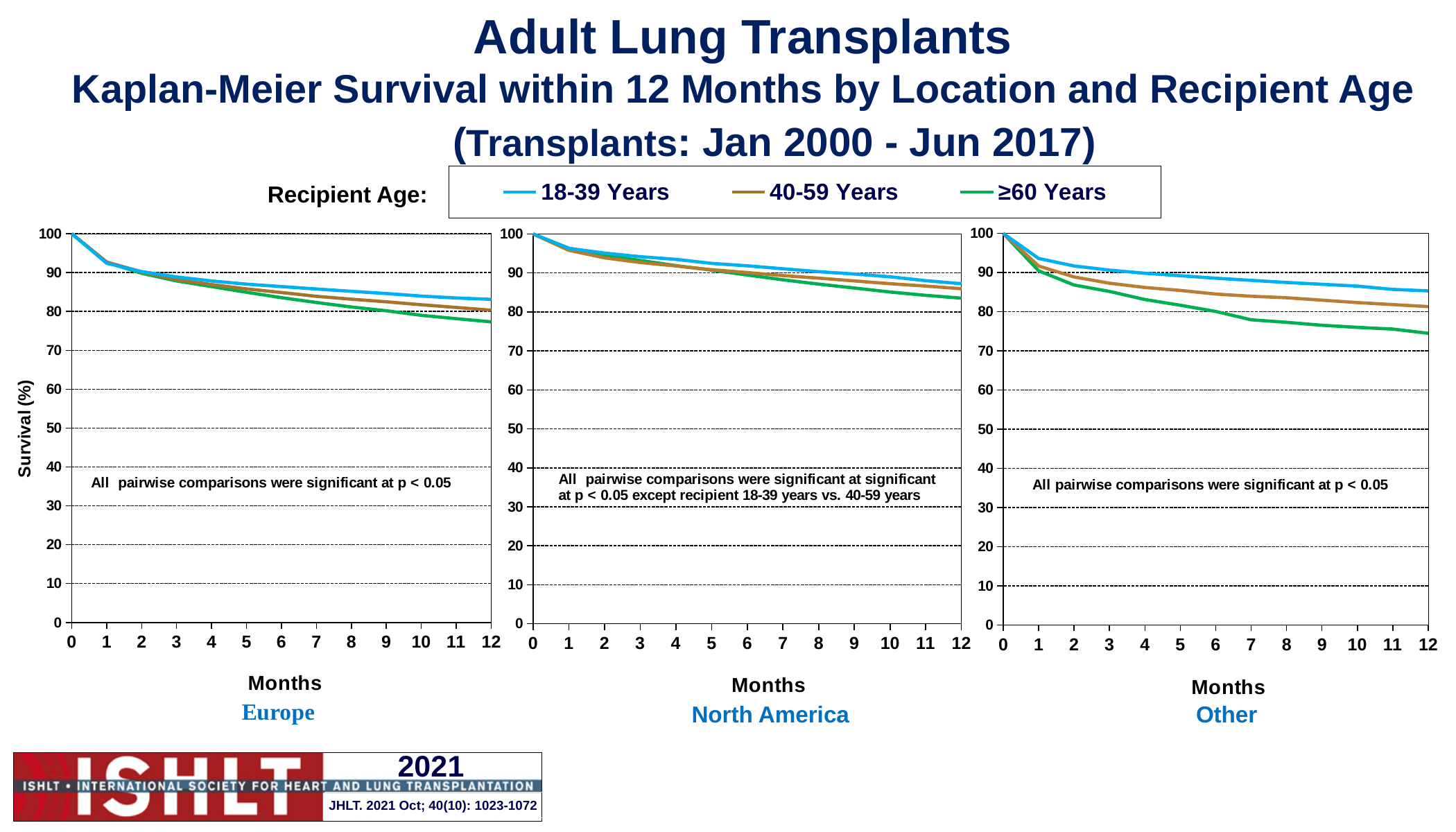
In the North America chart, do the survival values rise or fall as months increase? fall In the Other chart, which series has the lowest survival at month 12? ≥60 Years In the Europe chart, is the value for 18-39 Years at month 12 greater or less than 80? greater What kind of chart is the Europe chart? line chart How many charts are shown on the slide? 3 How many series does the legend list? 3 In the Europe chart, is the value for ≥60 Years at month 12 greater or less than 80? less In the North America chart, is the value for ≥60 Years at month 12 greater or less than 80? greater What colour is the line for the ≥60 Years series in the legend? green In the Europe chart, what is the survival value at month 0 for the 18-39 Years series? 100 In the Other chart, at month 12, which is larger: the value for 18-39 Years or the value for ≥60 Years? 18-39 Years